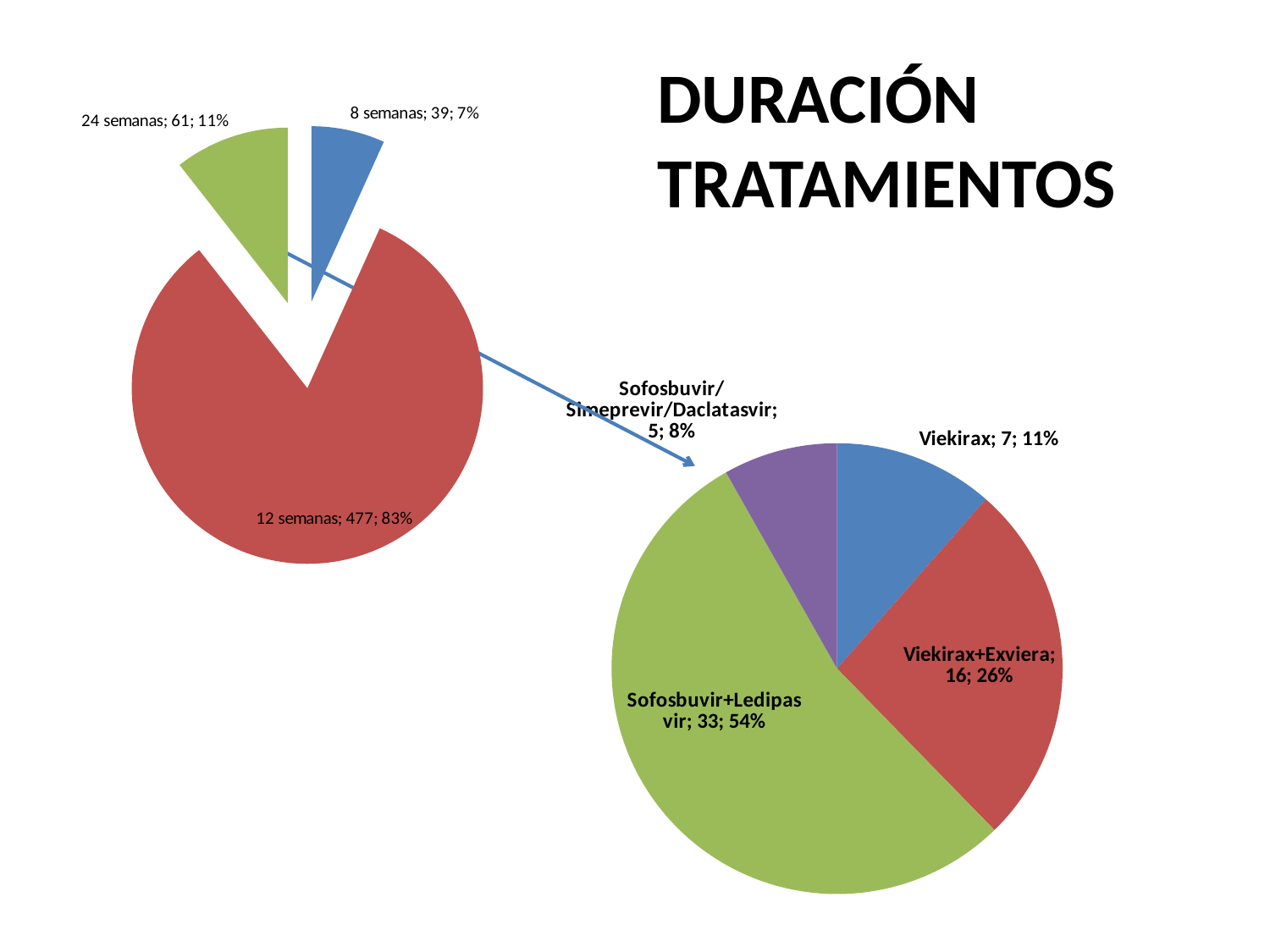
On the pie chart at the top left of the slide, what value is shown for 8 semanas? 39 On the pie chart at the bottom right of the slide, what percentage is shown for Sofosbuvir+Ledipasvir? 54% On the pie chart at the bottom right of the slide, which is larger, Viekirax or Viekirax+Exviera? Viekirax+Exviera On the pie chart at the top left of the slide, what is the difference between the values for 24 semanas and 8 semanas? 22 On the pie chart at the top left of the slide, what percentage is shown for 24 semanas? 11% On the pie chart at the top left of the slide, which category has the smallest slice? 8 semanas What type of chart is shown at the bottom right of the slide? Pie chart On the pie chart at the top left of the slide, which category has the largest slice? 12 semanas How many slices does the pie chart at the top left of the slide have? 3 On the pie chart at the bottom right of the slide, what value is shown for Viekirax+Exviera? 16 On the pie chart at the bottom right of the slide, which category has the smallest slice? Sofosbuvir/Simeprevir/Daclatasvir On the pie chart at the top left of the slide, what value is shown for 12 semanas? 477